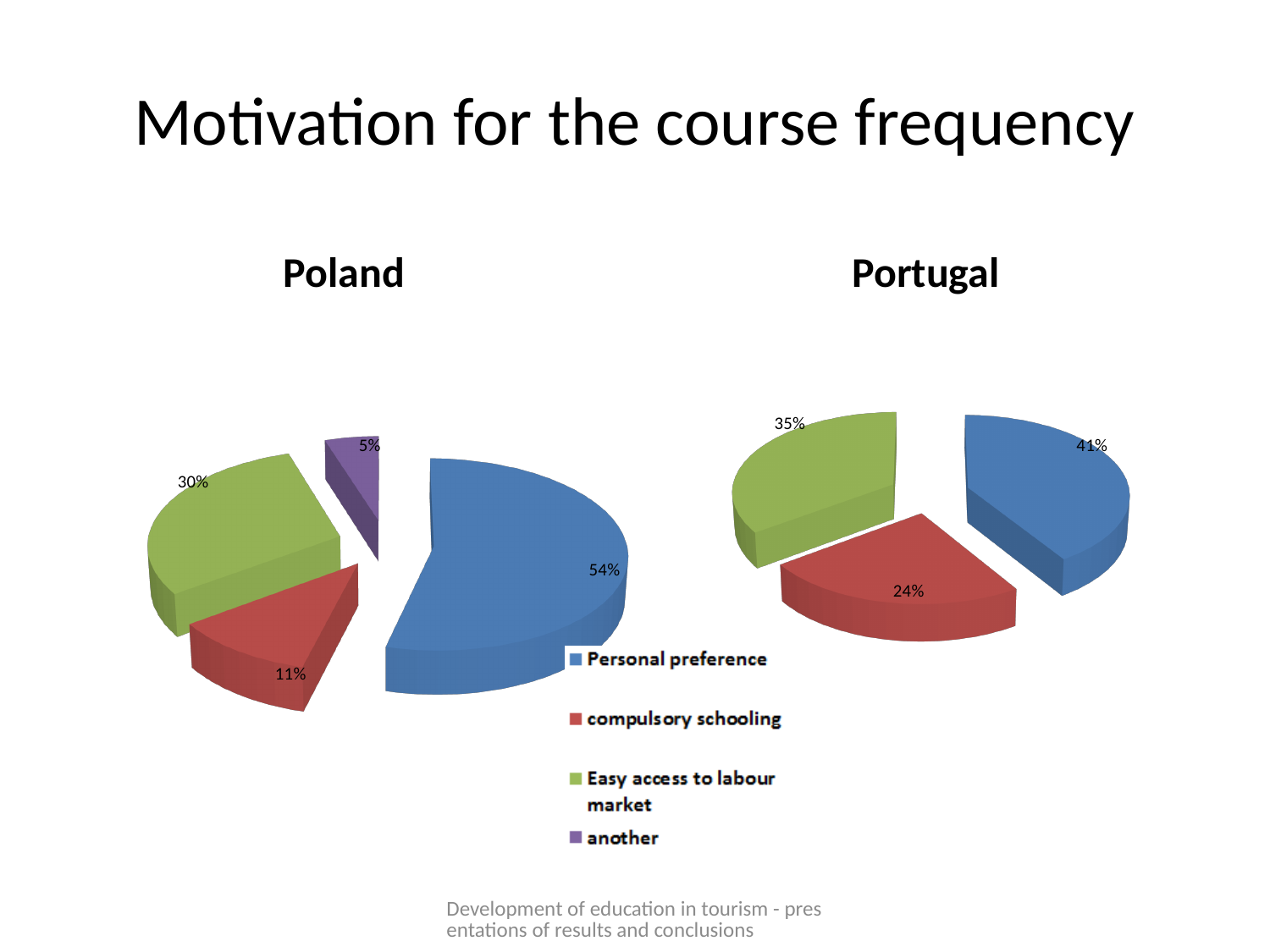
In the Portugal chart, which category has the smallest share? compulsory schooling How many entries does the legend list? 4 In the Poland chart, what share is Easy access to labour market? 30% In the Poland chart, which category has the smallest share? another In the Poland chart, which category has the largest share? Personal preference What type of chart is used for Poland? Pie chart In the Portugal chart, what share is Easy access to labour market? 35% How many slices does the Portugal chart have? 3 In the Poland chart, what share is Personal preference? 54% In the Portugal chart, what share is compulsory schooling? 24% Which is larger: compulsory schooling in the Poland chart or compulsory schooling in the Portugal chart? Portugal What is the difference between the Personal preference share in the Poland chart and in the Portugal chart? 13%